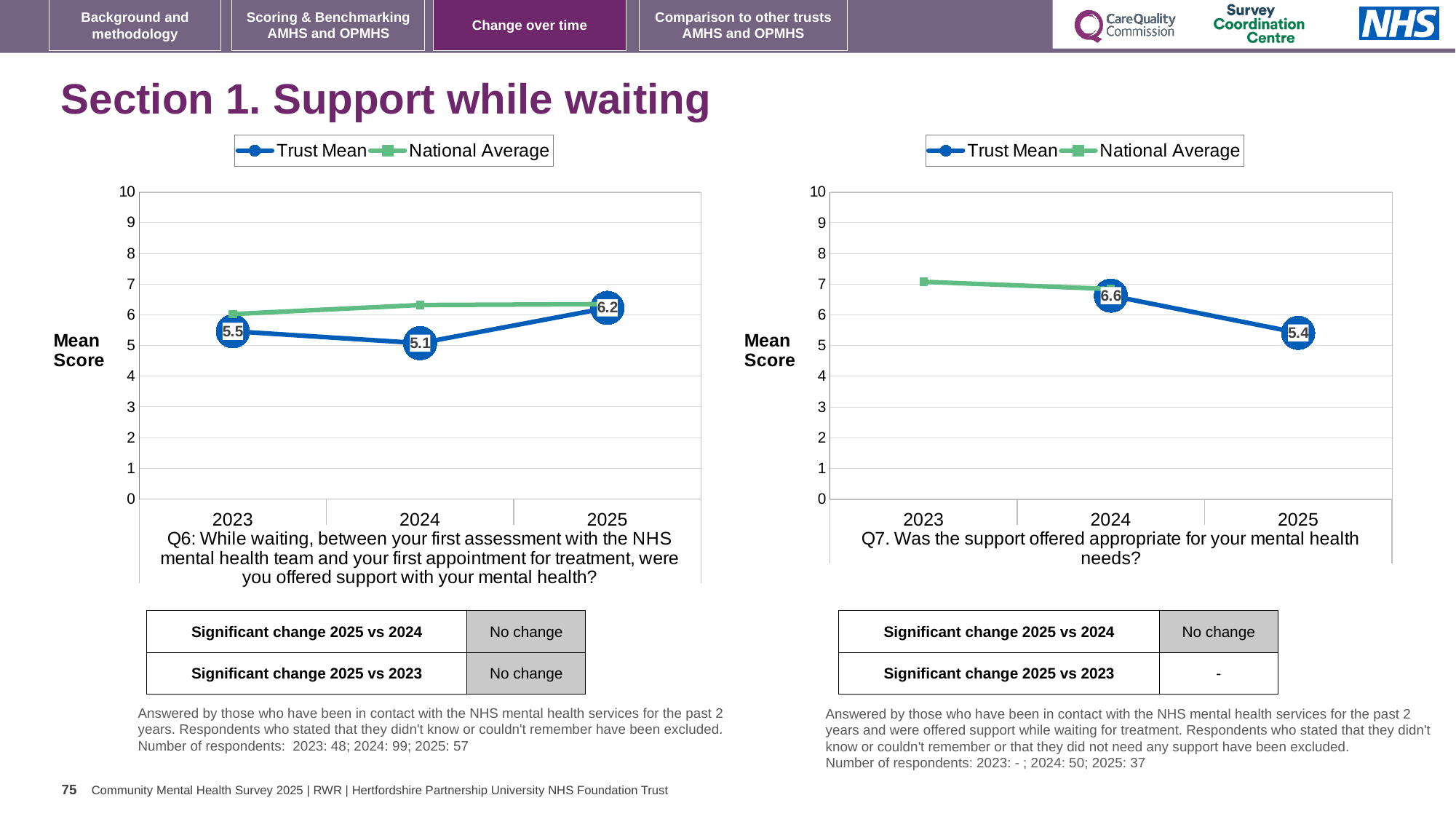
In the Q6 chart on the left, which year has the lowest Trust Mean? 2024 In the Q6 chart on the left, what is the Trust Mean for 2025? 6.2 In the Q7 chart on the right, what is the Trust Mean for 2025? 5.4 What type of chart is the Q7 chart on the right? line chart In the Q7 chart on the right, what is the Trust Mean for 2024? 6.6 In the Q7 chart on the right, is the National Average for 2023 greater or less than 6? greater In the Q6 chart on the left, what is the Trust Mean for 2024? 5.1 In the Q6 chart on the left, what is the difference between the Trust Mean in 2025 and in 2024? 1.1 In the Q6 chart on the left, is the National Average for 2023 greater or less than 5? greater How many series does the legend of the Q6 chart on the left list? 2 In the Q7 chart on the right, does the Trust Mean rise or fall from 2024 to 2025? fall In the Q6 chart on the left, which year has the highest Trust Mean? 2025